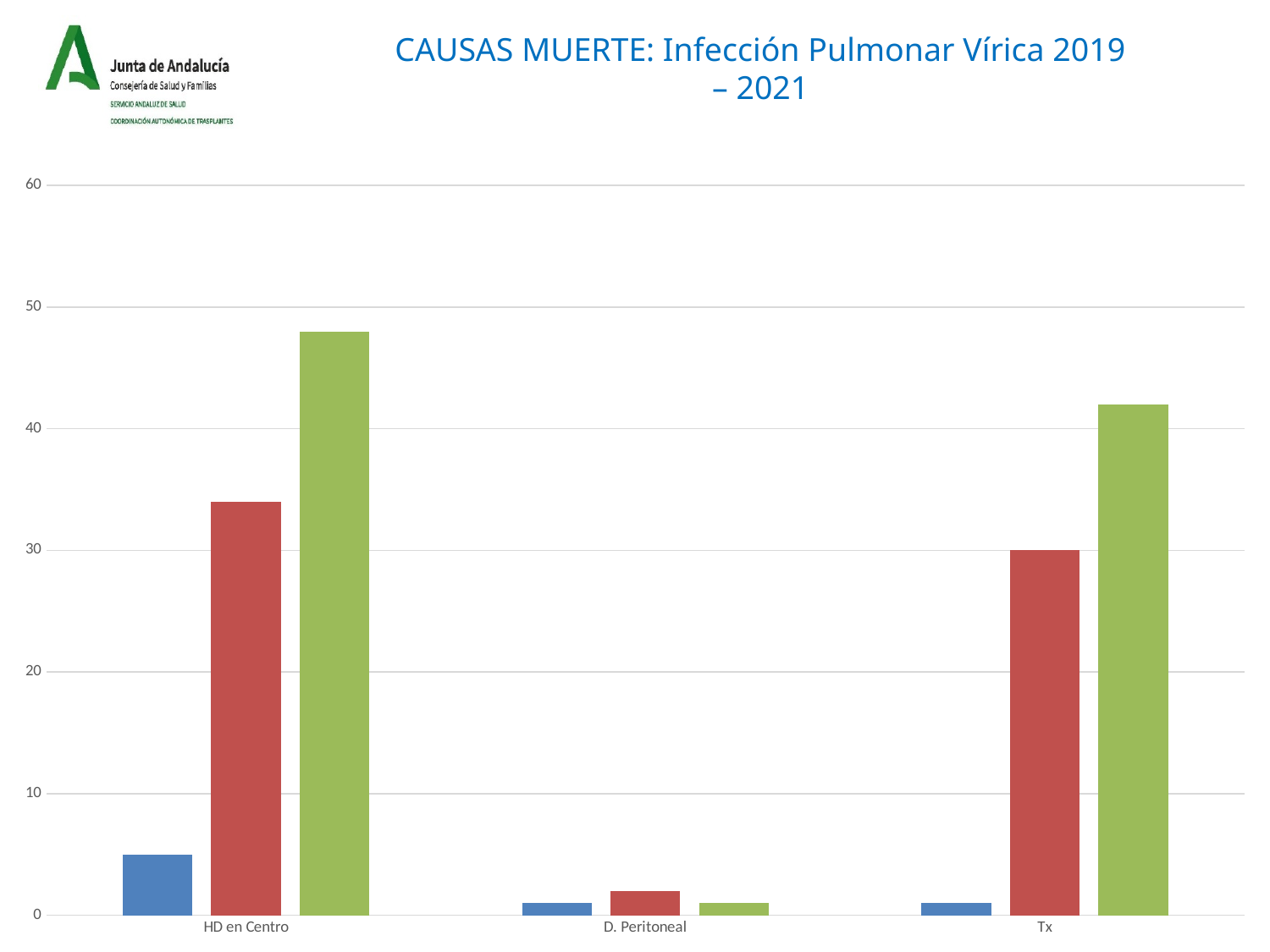
How many categories are shown on the x axis? 3 Is the value of the blue bar for HD en Centro greater or less than 10? less Is the value of the green bar for Tx greater or less than 40? greater What kind of chart is shown on the slide? bar chart Which category has the tallest bar in the chart? HD en Centro Which is larger, the red bar for Tx or the blue bar for Tx? the red bar Is the value of the green bar for HD en Centro greater or less than 50? less What is the title of the chart? CAUSAS MUERTE: Infección Pulmonar Vírica 2019 – 2021 Which is larger, the green bar for HD en Centro or the green bar for Tx? HD en Centro Which category has the lowest values across all three bars? D. Peritoneal